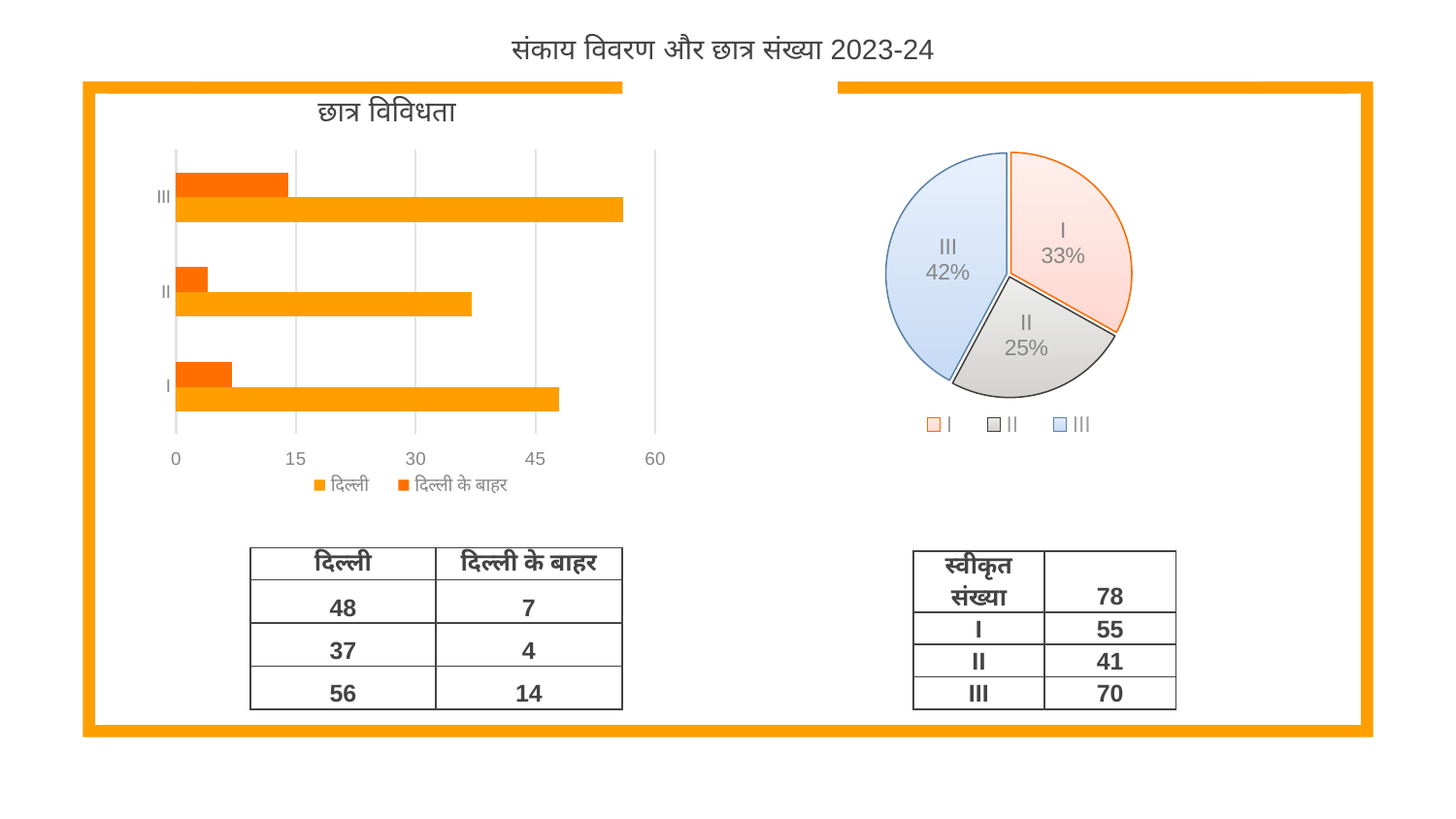
In the छात्र विविधता bar chart, which category has the shortest दिल्ली bar? II In the pie chart on the right of the slide, which slice is the smallest? II In the pie chart on the right of the slide, what is the difference in percentage points between slice III and slice II? 17 In the छात्र विविधता bar chart, is the दिल्ली के बाहर value for II greater or less than 15? less In the pie chart on the right of the slide, what share does slice I have? 33% How many series does the legend of the छात्र विविधता bar chart list? 2 What kind of chart is the chart titled छात्र विविधता on the left of the slide? bar chart In the छात्र विविधता bar chart, is the दिल्ली value for III greater or less than 45? greater In the छात्र विविधता bar chart, which is larger for category I: the दिल्ली bar or the दिल्ली के बाहर bar? दिल्ली In the pie chart on the right of the slide, what share does slice III have? 42% In the छात्र विविधता bar chart, which category has the longest दिल्ली bar? III How many categories are shown on the y axis of the छात्र विविधता bar chart? 3